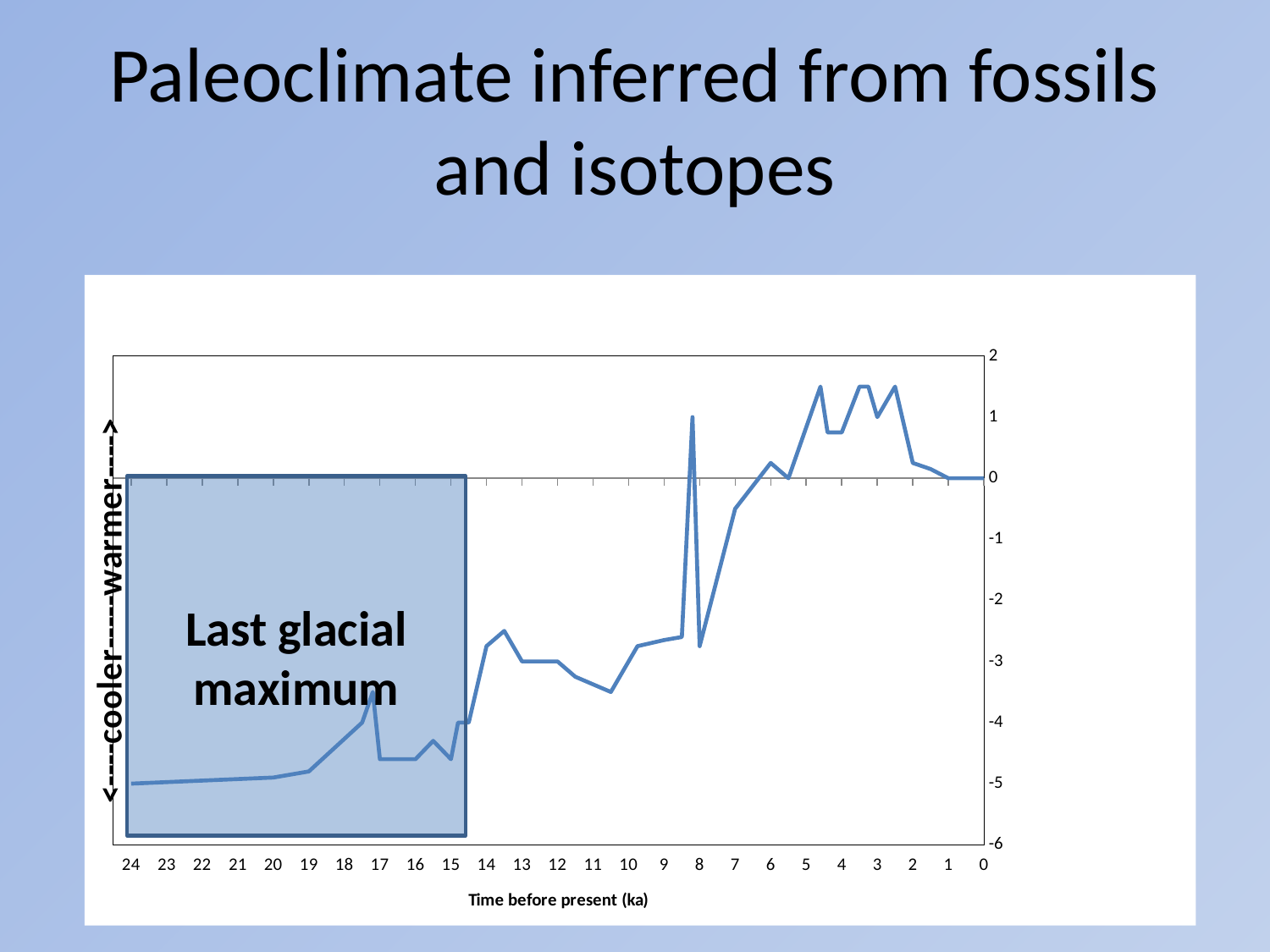
What is the highest value shown on the vertical axis of the chart? 2 Is the value at 11 ka greater or less than -3? less Which is larger, the value at 12 ka or the value at 4 ka? 4 ka Is the value at 5 ka greater or less than 1? greater Which is larger, the value at 5 ka or the value at 24 ka? 5 ka What kind of chart is shown on the slide? line chart Is the value at 24 ka greater or less than -4? less What label is written inside the shaded rectangle on the left of the chart? Last glacial maximum Reading the chart from 24 ka on the left to 0 ka on the right, do the values overall rise or fall? rise What is the title of the x axis of the chart? Time before present (ka)